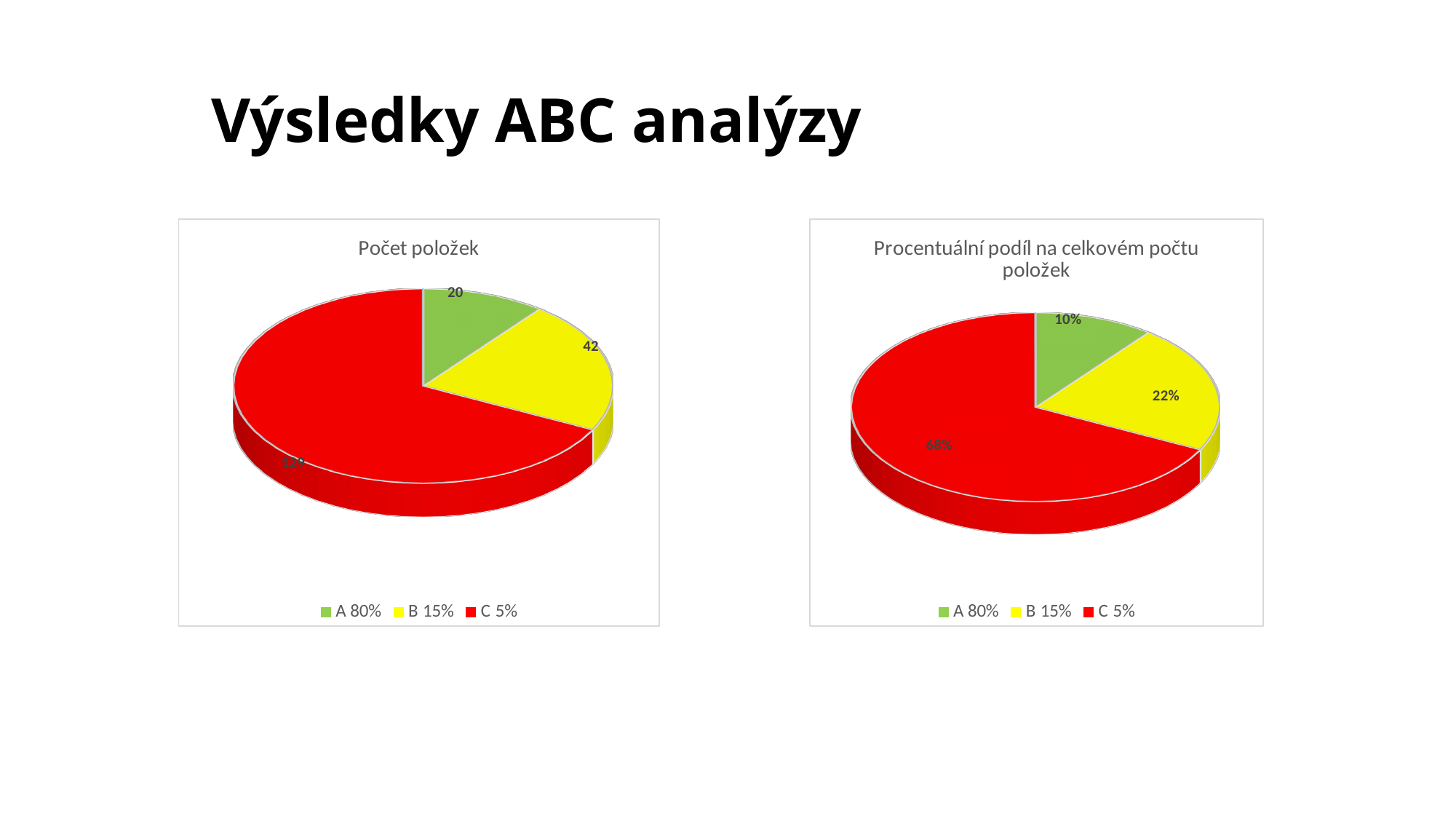
In the left chart "Počet položek", what is the value for A 80%? 20 In the left chart "Počet položek", what is the value for B 15%? 42 In the right chart "Procentuální podíl na celkovém počtu položek", which is larger, the slice for A 80% or the slice for B 15%? B 15% What kind of chart is the left chart titled "Počet položek"? pie chart In the right chart "Procentuální podíl na celkovém počtu položek", what is the value for B 15%? 22% What is the title of the left chart? Počet položek In the right chart "Procentuální podíl na celkovém počtu položek", how many slices does the pie have? 3 In the left chart "Počet položek", which category has the smallest slice? A 80% In the left chart "Počet položek", what is the difference between the values for B 15% and A 80%? 22 In the right chart "Procentuální podíl na celkovém počtu položek", what is the value for C 5%? 68% In the right chart "Procentuální podíl na celkovém počtu položek", what is the value for A 80%? 10% In the left chart "Počet položek", which category has the largest slice? C 5%